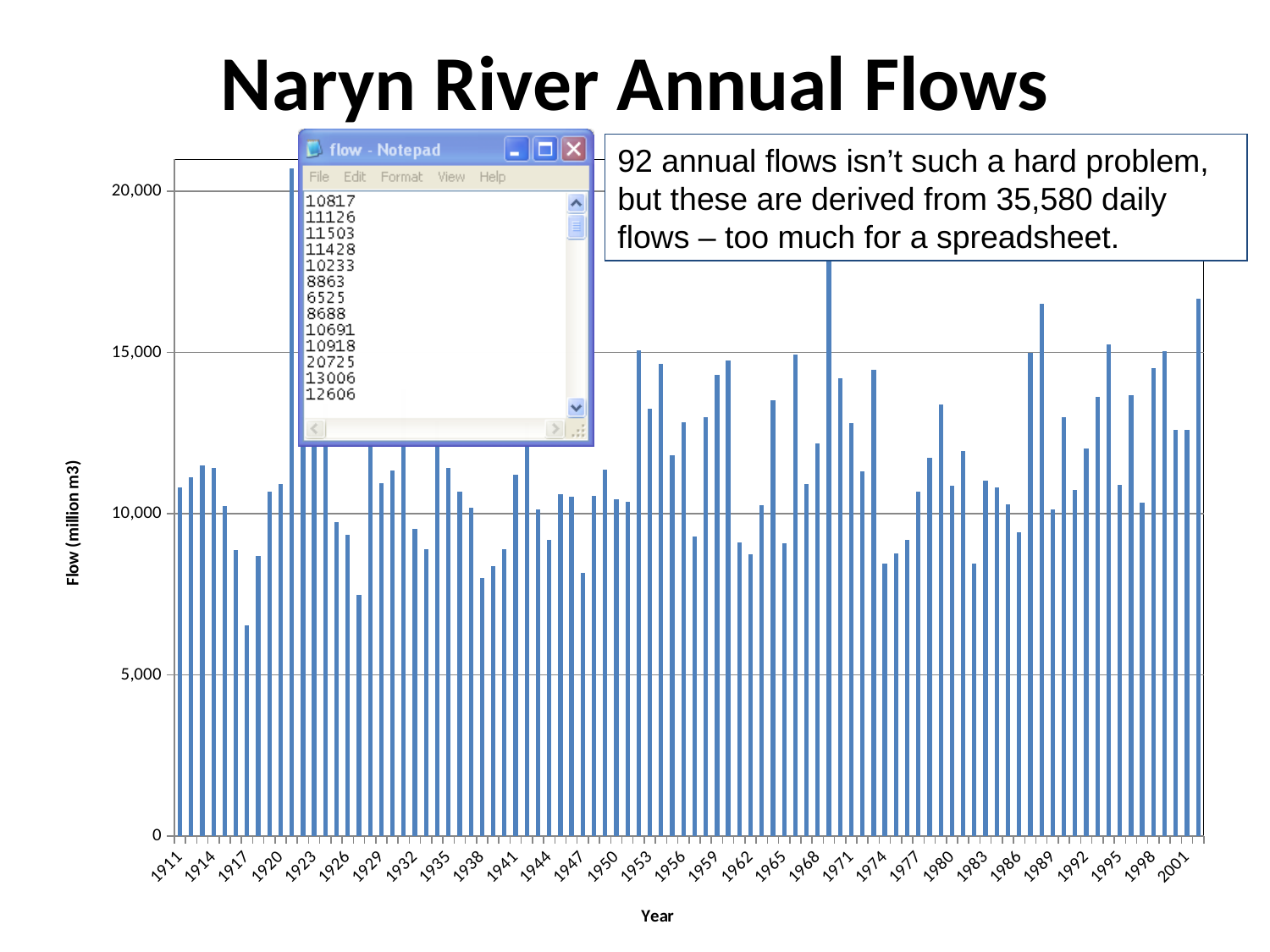
Is the value for 1970 greater or less than 15,000? less How many annual flow values are plotted in the chart? 92 Which year has the lowest annual flow? 1917 What is the label of the vertical axis? Flow (million m3) Is the value for 1989 greater or less than 15,000? less Is the value for 1926 greater or less than 10,000? less What is the title of the chart? Naryn River Annual Flows Which year has the larger annual flow, 1921 or 1970? 1921 Which year has the highest annual flow? 1921 What kind of chart is shown on the slide? bar chart